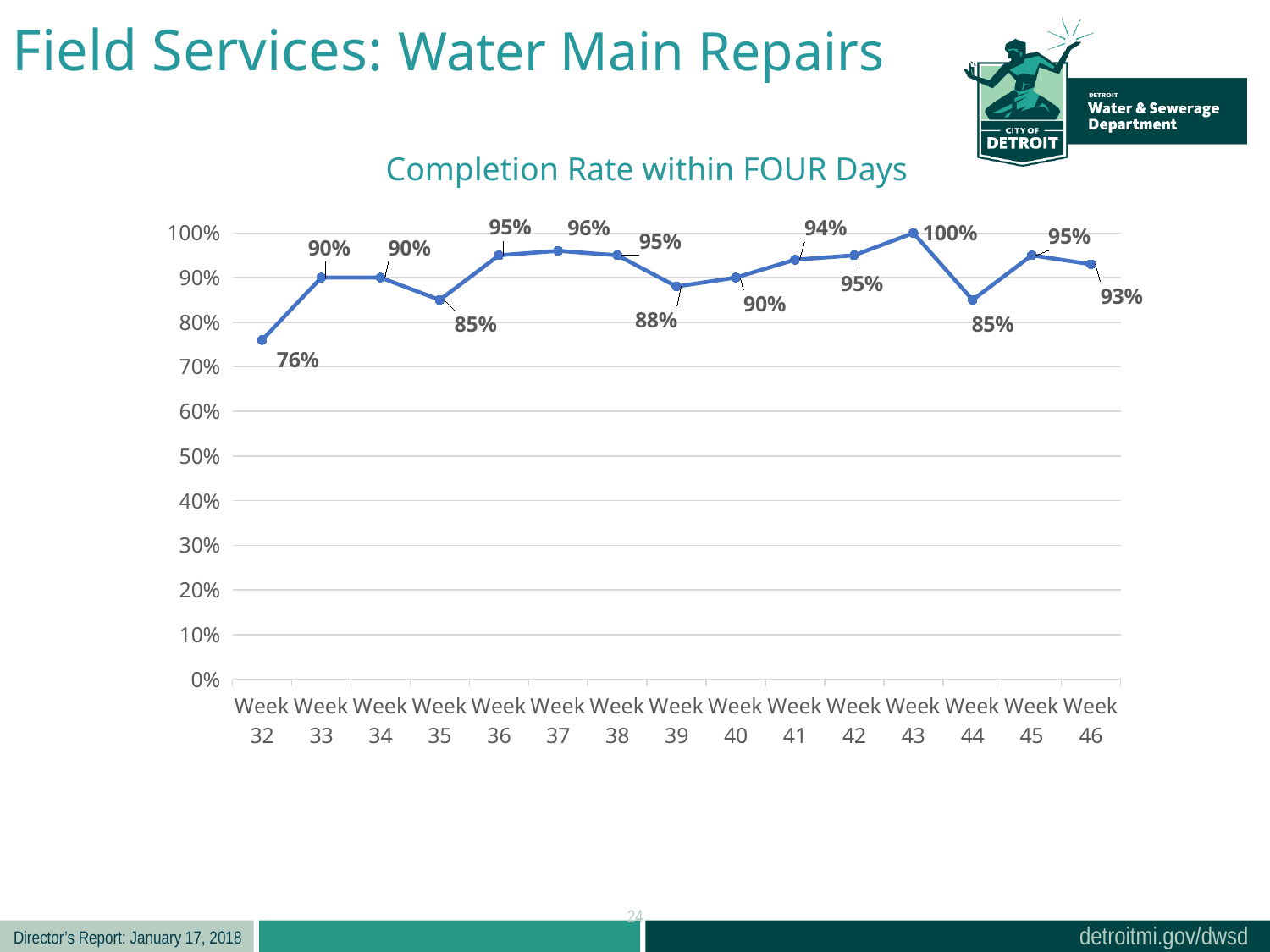
How many weeks are plotted on the chart? 15 What is the difference between the completion rate in Week 43 and Week 44? 15% What is the completion rate within four days for Week 46? 93% What is the completion rate within four days for Week 32? 76% What is the difference between the completion rate in Week 33 and Week 32? 14% Which week has a higher completion rate, Week 35 or Week 36? Week 36 Which week has the highest completion rate within four days? Week 43 Which week has the lowest completion rate within four days? Week 32 What is the title of the chart? Completion Rate within FOUR Days What is the completion rate within four days for Week 37? 96% What kind of chart is shown on the slide? Line chart What is the completion rate within four days for Week 39? 88%